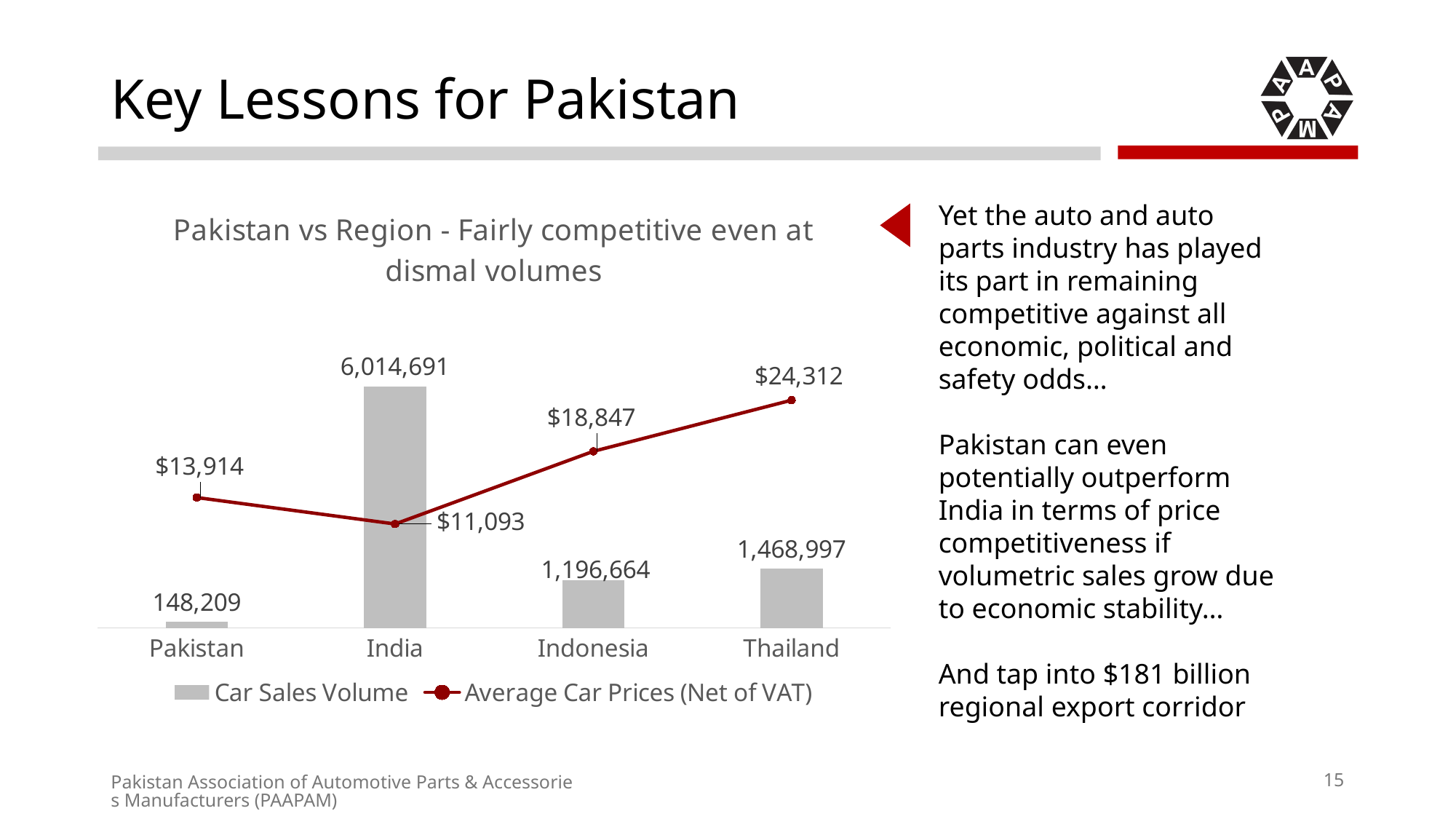
Which country has the highest Car Sales Volume? India What is the title of the chart? Pakistan vs Region - Fairly competitive even at dismal volumes What is the difference in Average Car Price (Net of VAT) between Thailand and Pakistan? $10,398 What is the Car Sales Volume for Pakistan? 148,209 What is the Average Car Price (Net of VAT) for Thailand? $24,312 Which has the larger Car Sales Volume, Indonesia or Thailand? Thailand What is the Average Car Price (Net of VAT) for Indonesia? $18,847 What is the Car Sales Volume for India? 6,014,691 Which country has the lowest Average Car Price (Net of VAT)? India Does the Average Car Price (Net of VAT) rise or fall from India to Thailand? rise How many series does the legend list? 2 How many countries are shown on the x axis? 4